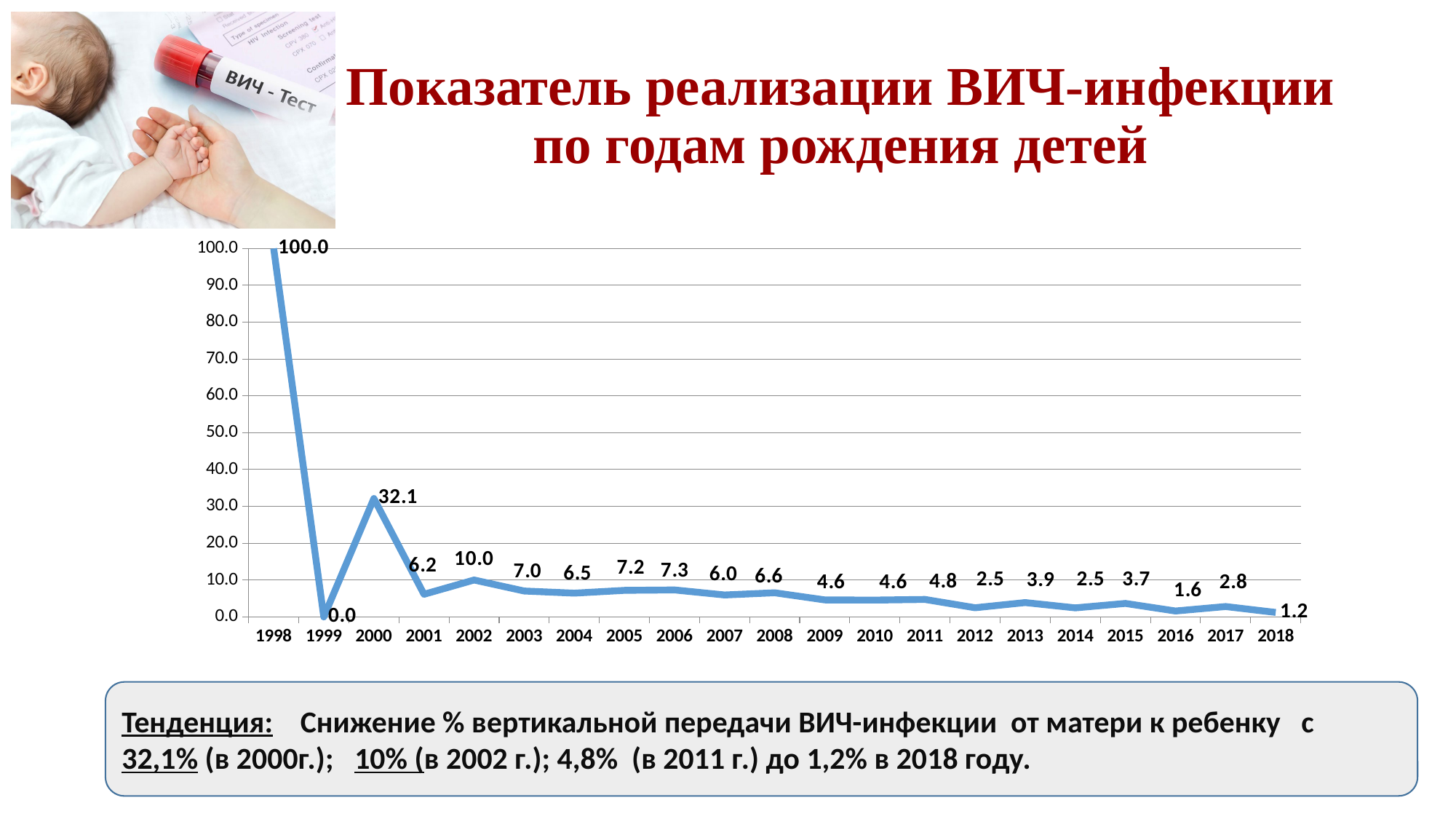
What kind of chart is this? line chart Which year has the lowest value? 1999 What is the title of the slide? Показатель реализации ВИЧ-инфекции по годам рождения детей What is the value for 2018? 1.2 What is the difference between the values for 2000 and 2002? 22.1 Which is larger, the value for 2006 or the value for 2009? 2006 What is the value for 2011? 4.8 Is the value for 2002 greater or less than 20.0? less Do the values generally rise or fall from 2000 to 2018? fall What is the value for 2000? 32.1 How many years are shown on the x axis? 21 Which year has the highest value? 1998